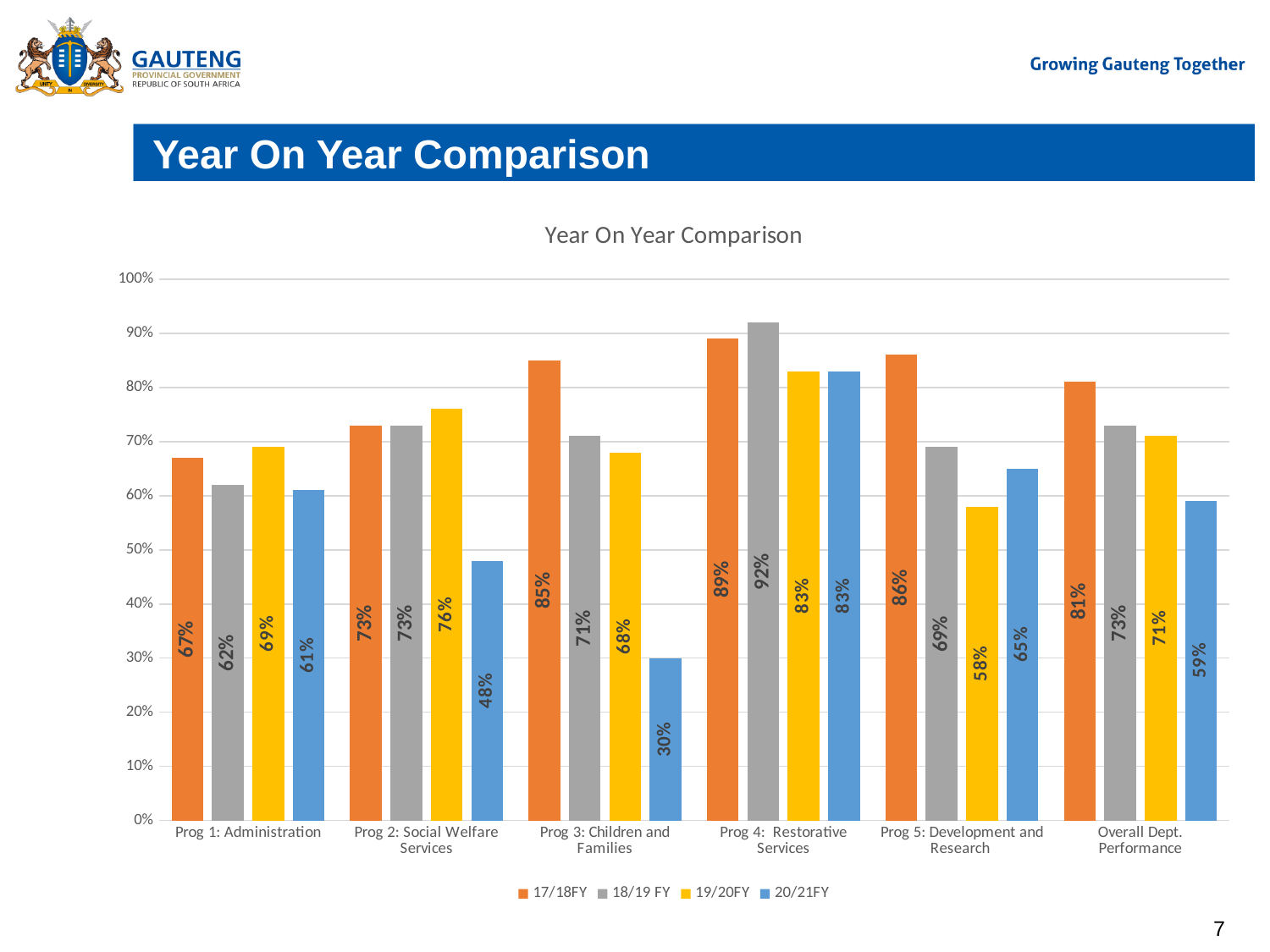
How many categories are shown on the x axis? 6 Which category has the highest value in the 18/19 FY series? Prog 4: Restorative Services How many series does the legend list? 4 What kind of chart is shown on the slide? Bar chart Which colour represents the 19/20FY series in the legend? Yellow Which is larger for Prog 2: Social Welfare Services, the 19/20FY value or the 20/21FY value? 19/20FY What is the value for Prog 1: Administration in the 20/21FY series? 61% What is the title of the chart? Year On Year Comparison What is the value for Prog 3: Children and Families in the 18/19 FY series? 71% What is the difference between the 17/18FY and 20/21FY values for Prog 5: Development and Research? 21% Which category has the lowest value in the 20/21FY series? Prog 3: Children and Families What is the Overall Dept. Performance value for 17/18FY? 81%